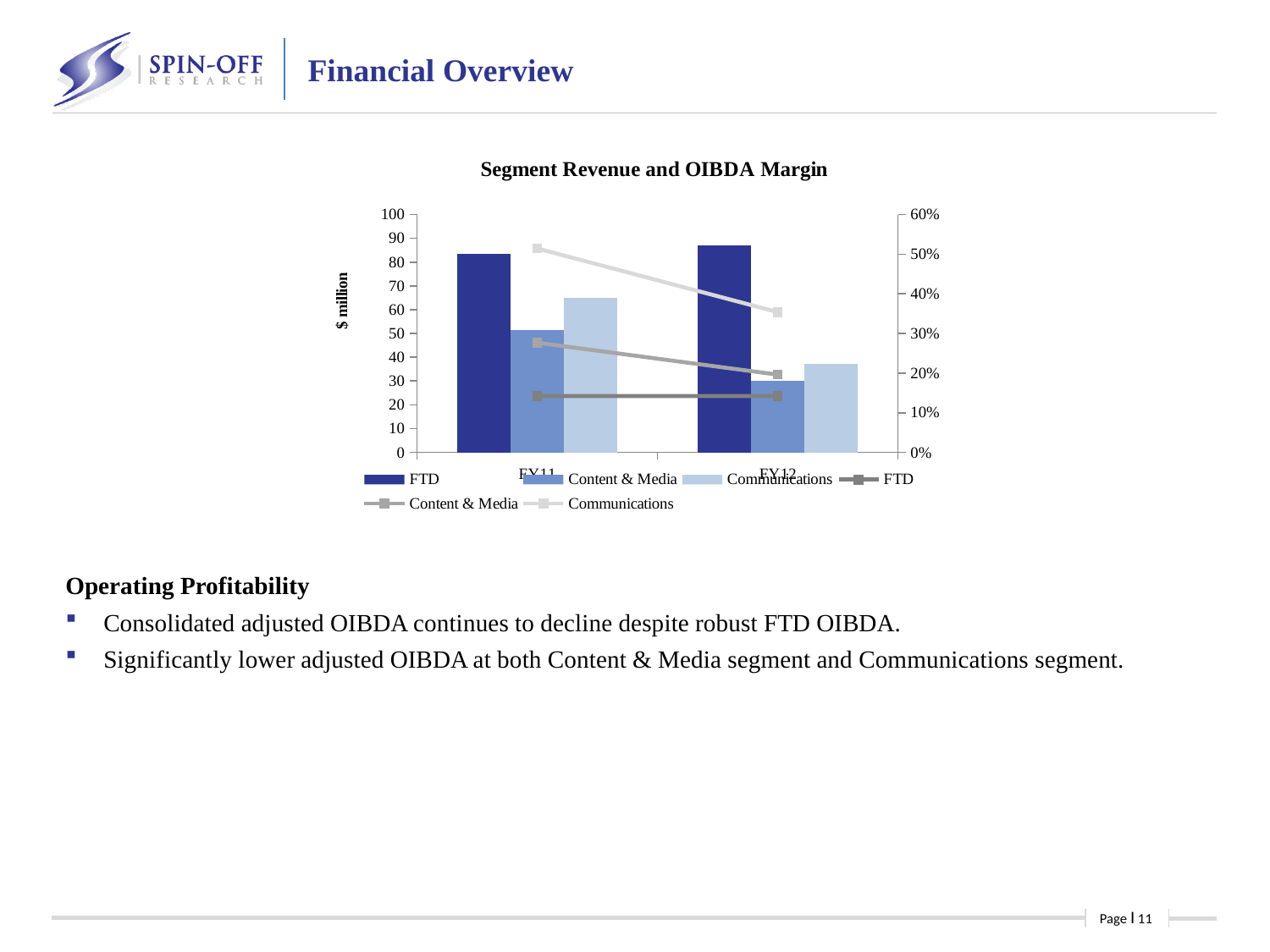
Is the FTD revenue bar for FY11 greater or less than 80? greater What is the title of the chart? Segment Revenue and OIBDA Margin How many categories are shown on the x axis of the chart? 2 Is the Content & Media revenue bar for FY12 greater or less than 40? less What kind of chart is shown on the slide? Combination bar and line chart Is the Communications revenue bar for FY11 greater or less than 60? greater Which segment has the lowest revenue bar in FY11? Content & Media Which is larger, the Communications revenue bar in FY11 or in FY12? FY11 Does the Communications OIBDA margin line rise or fall from FY11 to FY12? fall How many series does the chart legend list? 6 Which segment has the highest revenue bar in FY12? FTD What is the label of the left vertical axis? $ million